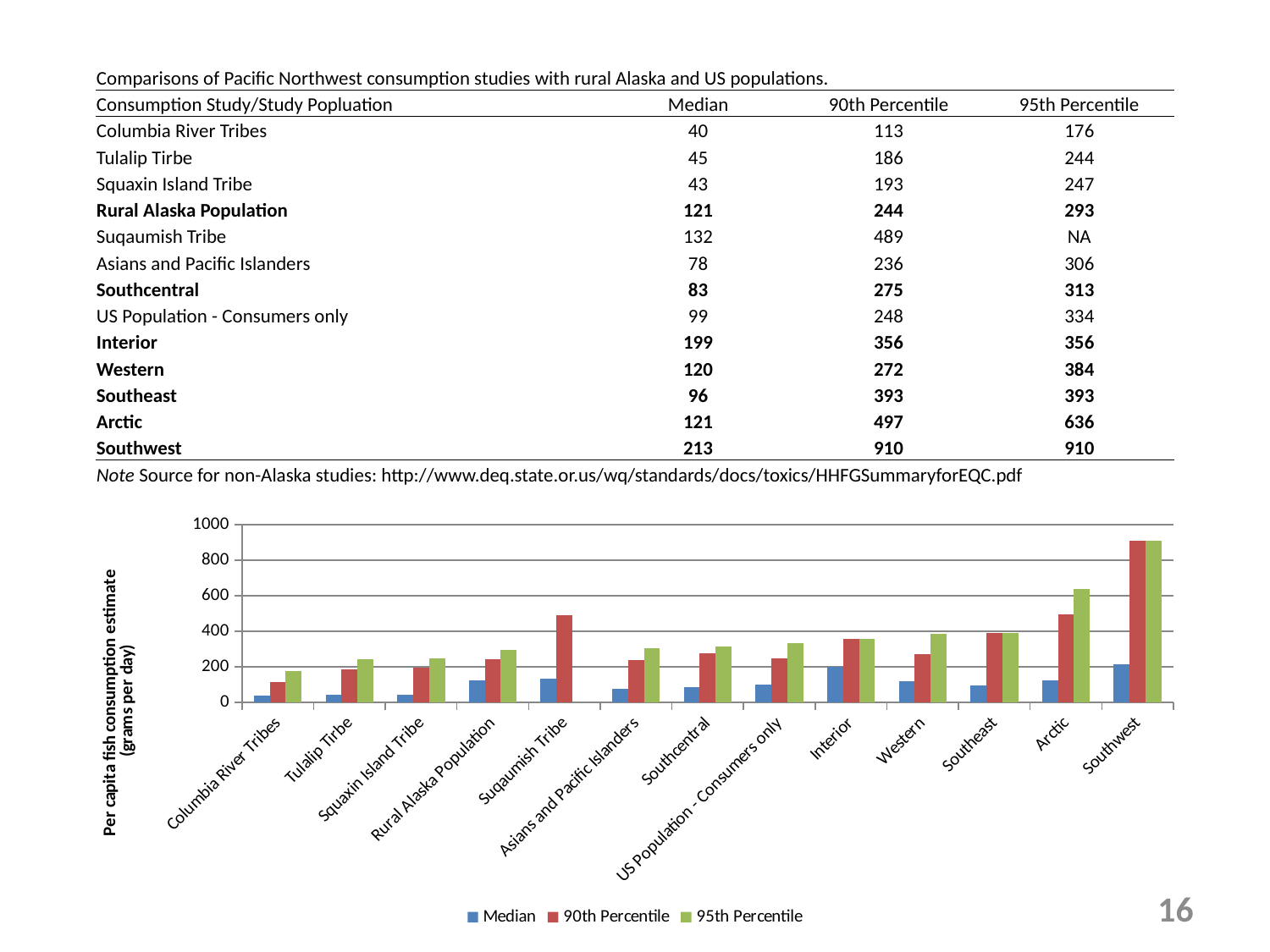
What is the Median value for Southwest? 213 How many study populations are shown along the x axis of the chart? 13 How many series does the chart legend list? 3 What is the label on the vertical axis of the chart? Per capita fish consumption estimate (grams per day) What is the 95th Percentile value for Arctic? 636 What kind of chart is shown on the slide? bar chart Is the Median value for Interior greater or less than 400? less Which is larger, the 95th Percentile value for Western or the 95th Percentile value for Southcentral? Western What is the difference between the 90th Percentile values for Southwest and Arctic? 413 Which study population has the highest 90th Percentile value? Southwest Is the 90th Percentile value for Suqaumish Tribe greater or less than 400? greater Which study population has the lowest Median value? Columbia River Tribes